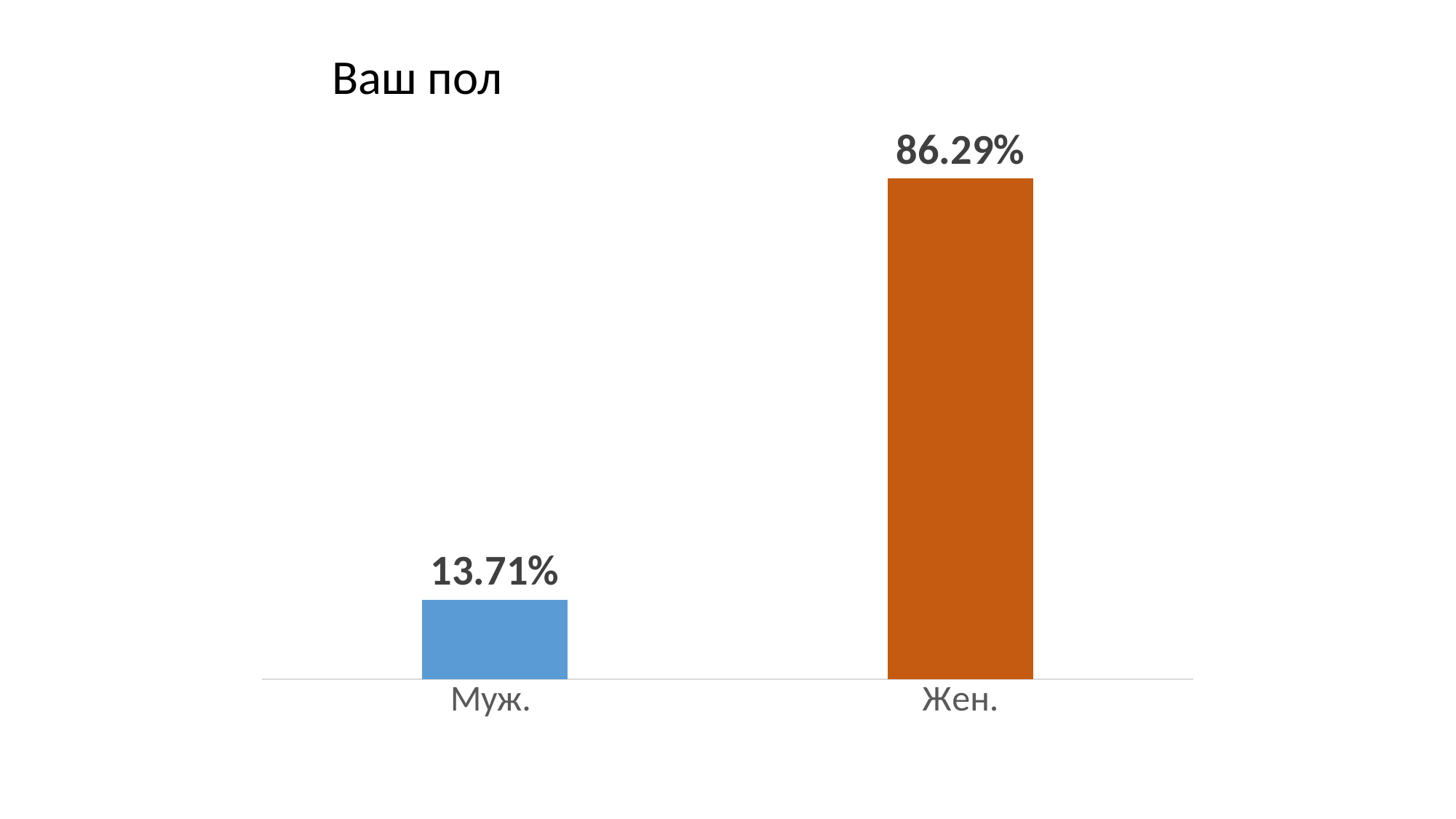
Which category has the lowest value? Муж. What is the total of the values for Муж. and Жен.? 100% What is the difference between the values for Жен. and Муж.? 72.58% What kind of chart is shown on the slide? Bar chart What is the value for Жен.? 86.29% Which category has the highest value? Жен. How many categories are shown in the chart? 2 What colour is the bar for Жен.? Orange What is the value for Муж.? 13.71% Which is larger, the value for Муж. or the value for Жен.? Жен. What is the title of the chart? Ваш пол